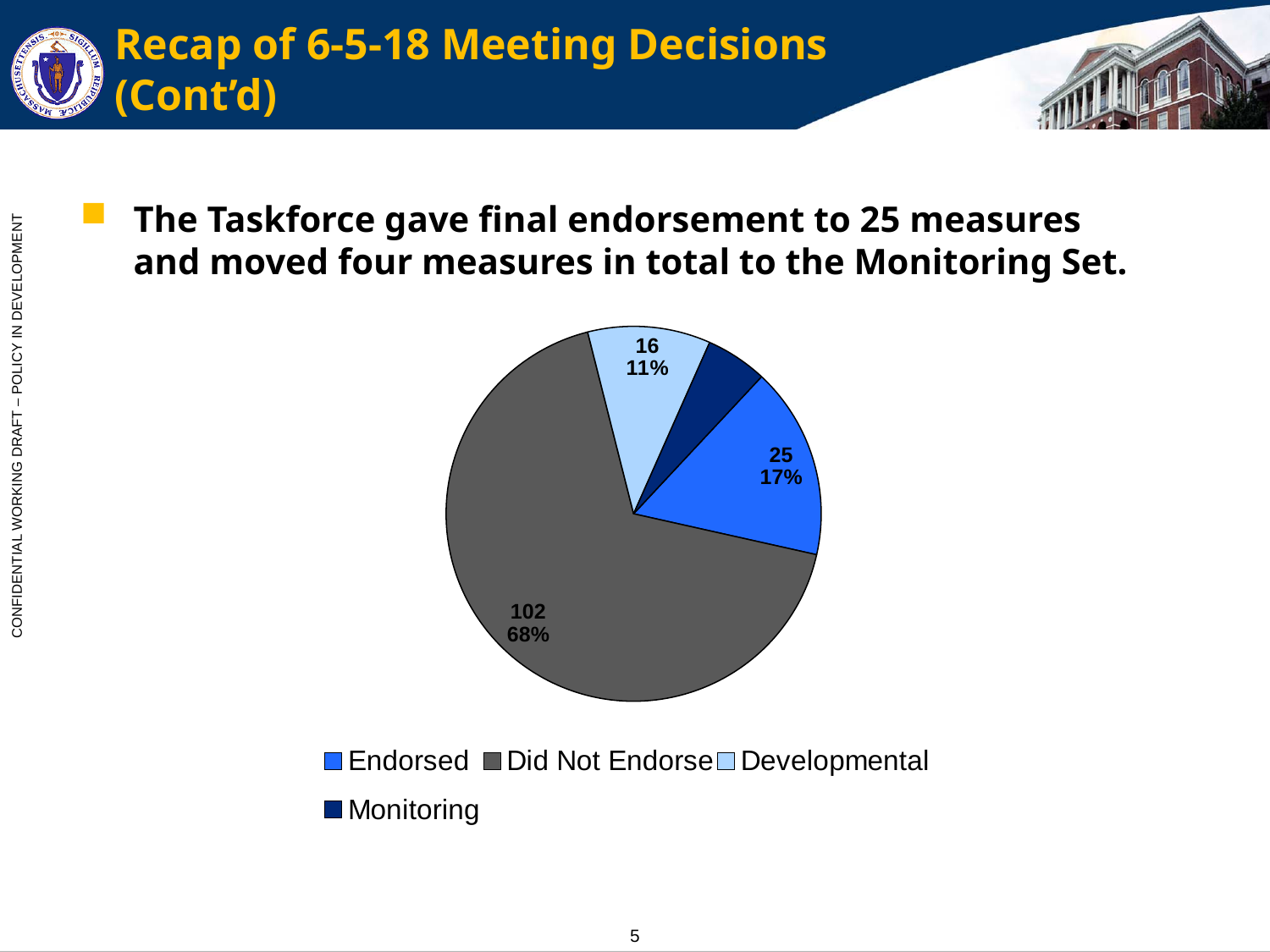
What percentage of the pie does the Did Not Endorse slice represent? 68% What kind of chart is shown on the slide? Pie chart What is the number of measures shown for the Developmental slice? 16 What percentage of the pie does the Endorsed slice represent? 17% What is the number of measures shown for the Did Not Endorse slice? 102 Which slice is larger, Endorsed or Developmental? Endorsed Which category has the largest slice of the pie? Did Not Endorse How many categories does the pie chart's legend list? 4 What is the difference between the Did Not Endorse count and the Endorsed count? 77 What is the number of measures shown for the Endorsed slice? 25 Which category has the smallest slice of the pie? Monitoring What percentage of the pie does the Developmental slice represent? 11%